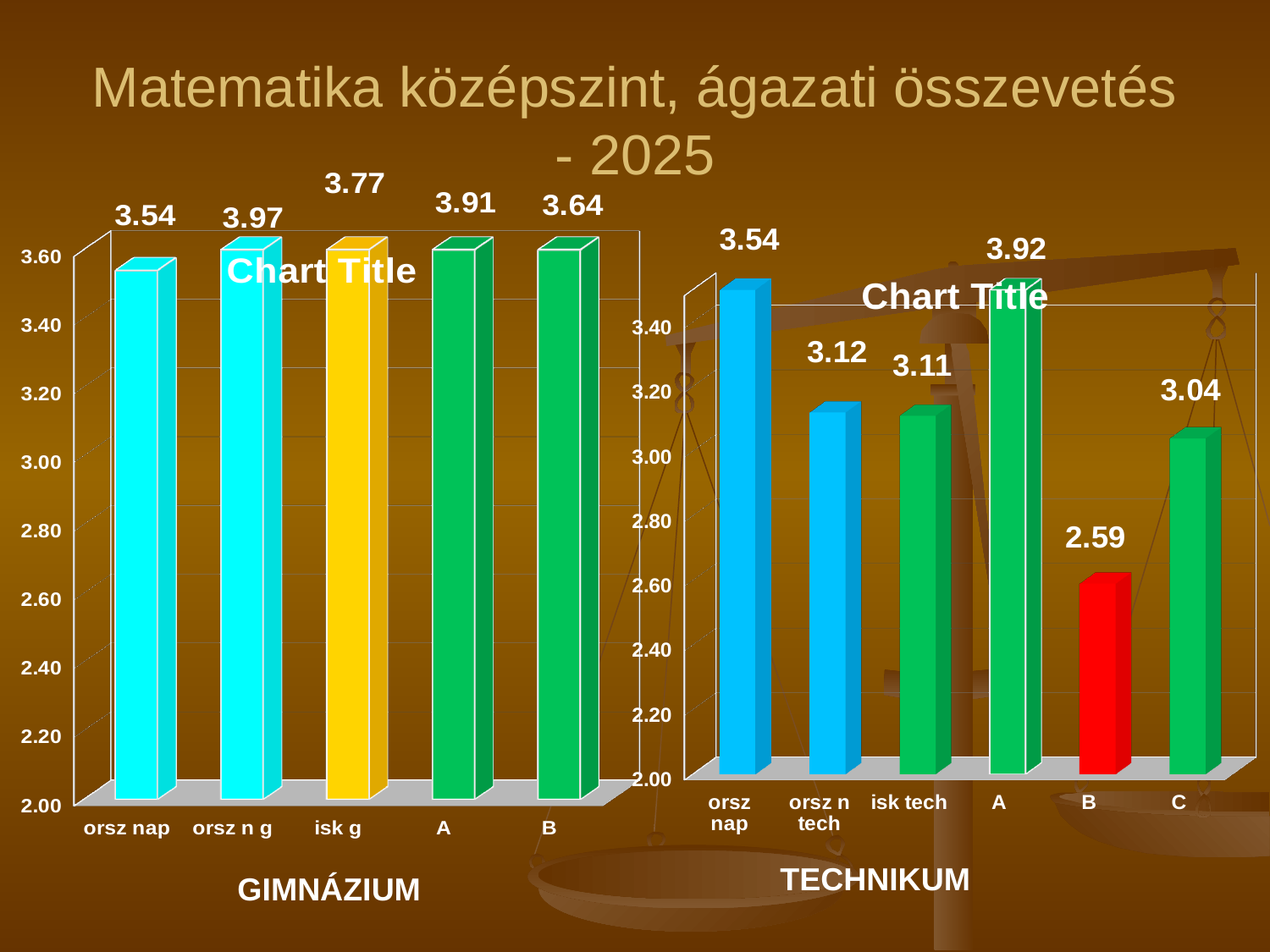
How many categories are shown in the TECHNIKUM chart on the right? 6 In the TECHNIKUM chart on the right, which category has the lowest value? B What kind of chart is the GIMNÁZIUM chart on the left? bar chart In the TECHNIKUM chart on the right, which category has the highest value? A In the GIMNÁZIUM chart on the left, which is larger, the value for A or the value for B? A In the TECHNIKUM chart on the right, what is the value for B? 2.59 In the GIMNÁZIUM chart on the left, which category has the highest value? orsz n g How many categories are shown in the GIMNÁZIUM chart on the left? 5 In the TECHNIKUM chart on the right, what is the difference between the values for A and B? 1.33 In the GIMNÁZIUM chart on the left, what is the value for isk g? 3.77 In the TECHNIKUM chart on the right, what is the value for orsz n tech? 3.12 In the GIMNÁZIUM chart on the left, which category has the lowest value? orsz nap